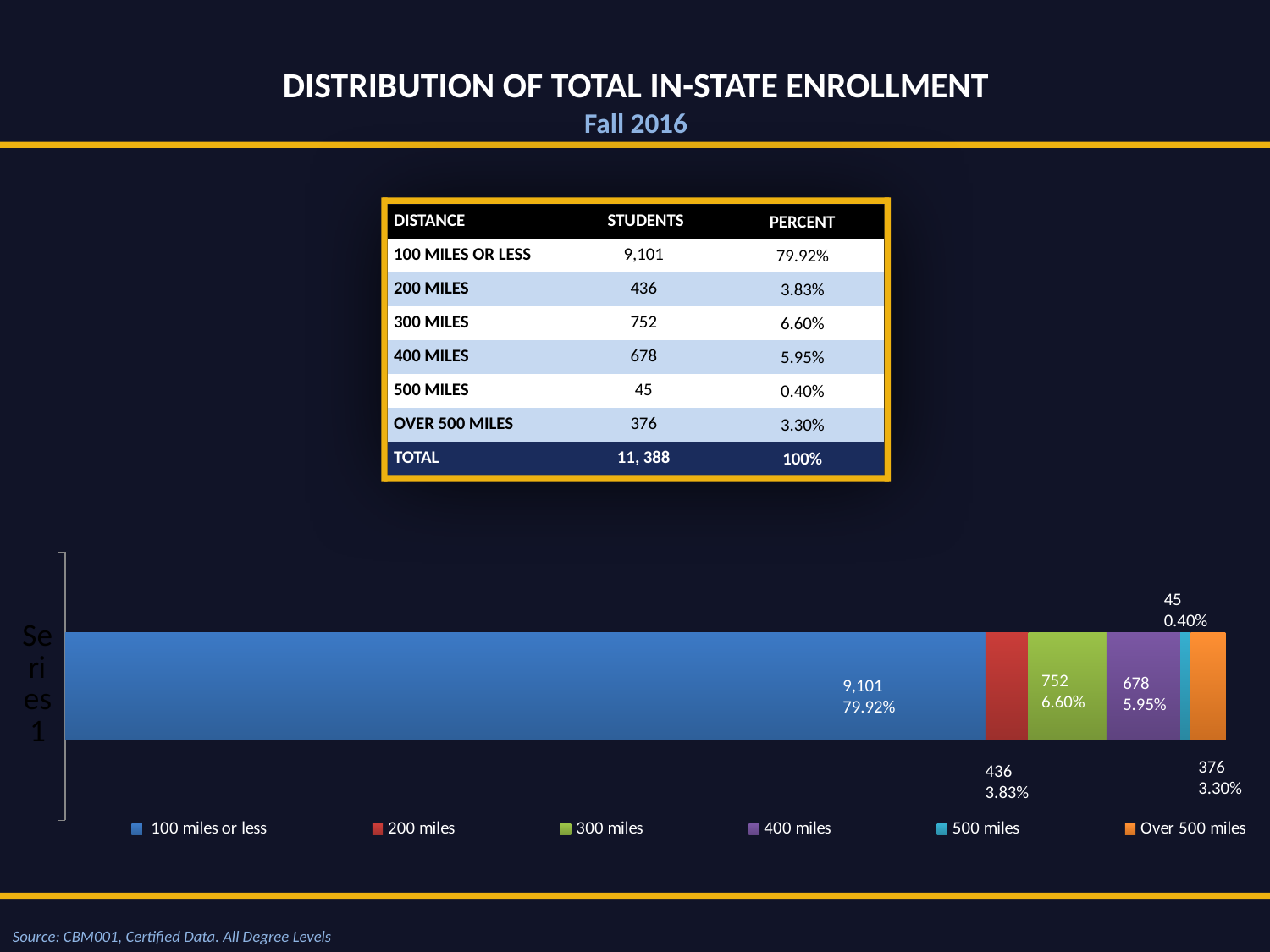
Which segment of the stacked bar is the largest? 100 miles or less What kind of chart is shown at the bottom of the slide? stacked bar chart In the chart, what percentage is shown for the '300 miles' segment? 6.60% How many series does the chart's legend list? 6 What colour is the '100 miles or less' segment in the chart? blue Which segment of the stacked bar is the smallest? 500 miles In the chart, what is the difference in students between the '300 miles' and '400 miles' segments? 74 In the chart, how many students are in the '100 miles or less' segment? 9,101 In the chart, what value is shown for the '500 miles' segment? 45 In the chart, which segment is larger: '300 miles' or '400 miles'? 300 miles In the chart, what is the difference in students between the '200 miles' and 'Over 500 miles' segments? 60 In the chart, what percentage is shown for the 'Over 500 miles' segment? 3.30%